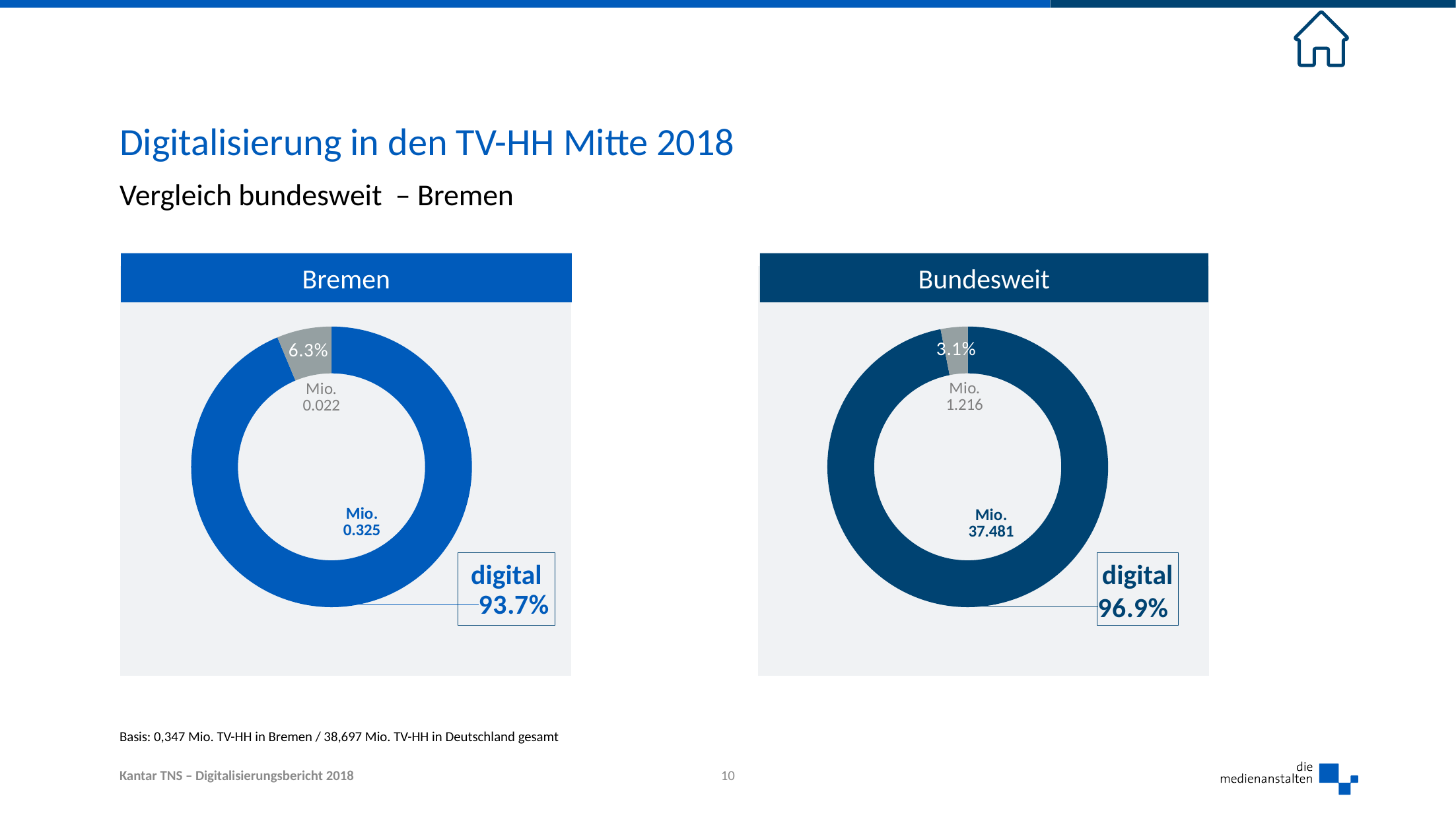
In the Bundesweit chart, how many million households does the digital slice represent? 37.481 Mio. What kind of chart is used for Bremen and Bundesweit on this slide? Donut (pie) chart Which chart shows the higher digital share, Bremen or Bundesweit? Bundesweit In the Bremen chart, how many million households does the digital slice represent? 0.325 Mio. In the Bundesweit chart, how many million households does the grey (non-digital) slice represent? 1.216 Mio. In the Bremen chart, how many million households does the grey (non-digital) slice represent? 0.022 Mio. How many slices does the Bremen chart have? 2 In the Bremen chart, what share of TV households is digital? 93.7% In the Bundesweit chart, what percentage is shown for the grey (non-digital) slice? 3.1% In the Bremen chart, what percentage is shown for the grey (non-digital) slice? 6.3% In the Bundesweit chart, what share of TV households is digital? 96.9% What is the difference in percentage points between the digital share in the Bundesweit chart and the digital share in the Bremen chart? 3.2 percentage points